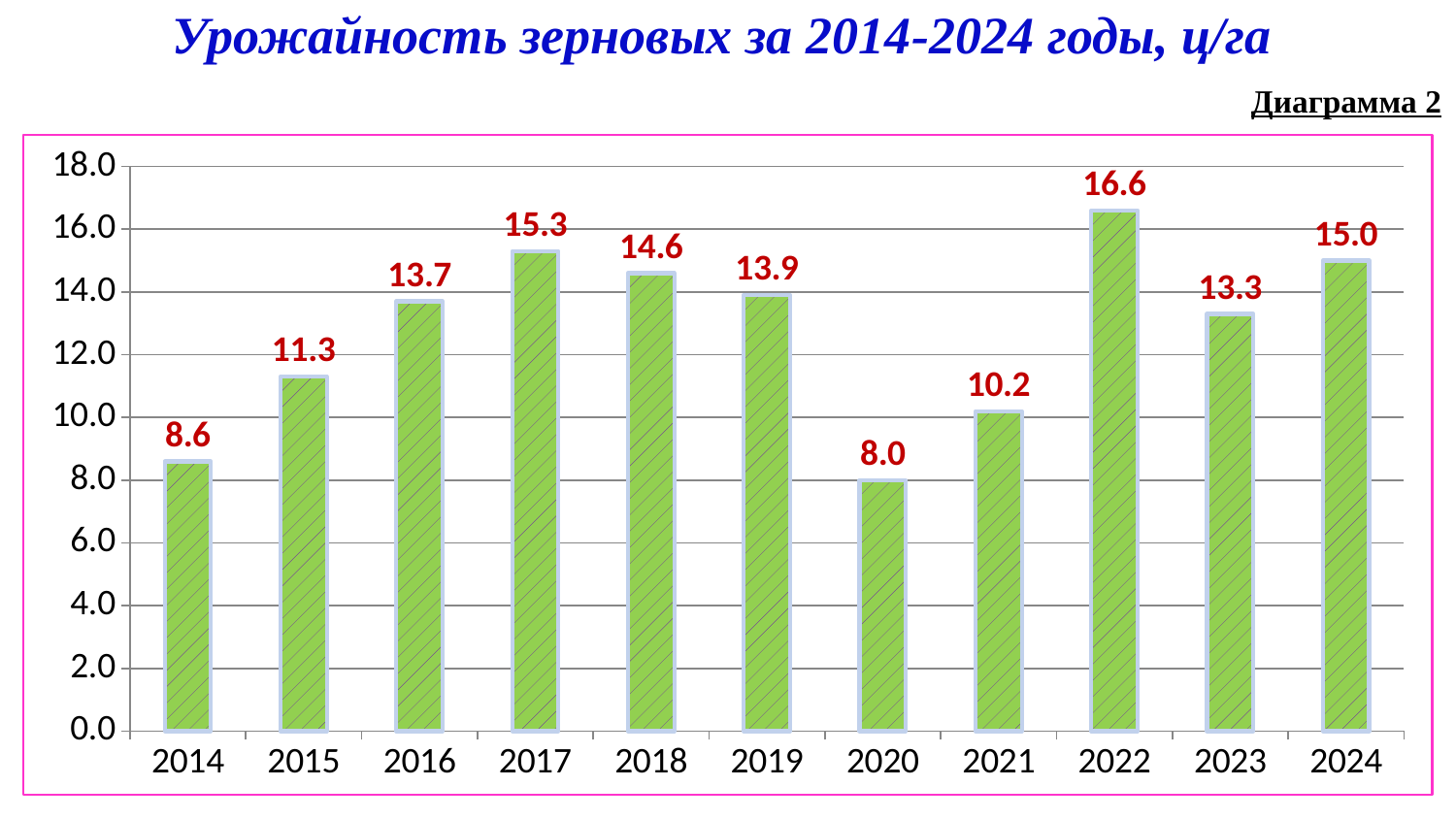
Which is larger, the value for 2018 or the value for 2019? 2018 What is the value shown for 2021? 10.2 What is the difference between the values for 2022 and 2020? 8.6 How many years are shown on the x axis? 11 Which year has the lowest grain yield? 2020 Which year has the highest grain yield? 2022 What is the grain yield value shown for 2017? 15.3 Is the value for 2015 greater or less than 12.0? less What kind of chart is shown on the slide? bar chart What is the difference between the values for 2024 and 2023? 1.7 Do the values rise or fall from 2014 to 2017? rise What is the title of the chart? Урожайность зерновых за 2014-2024 годы, ц/га